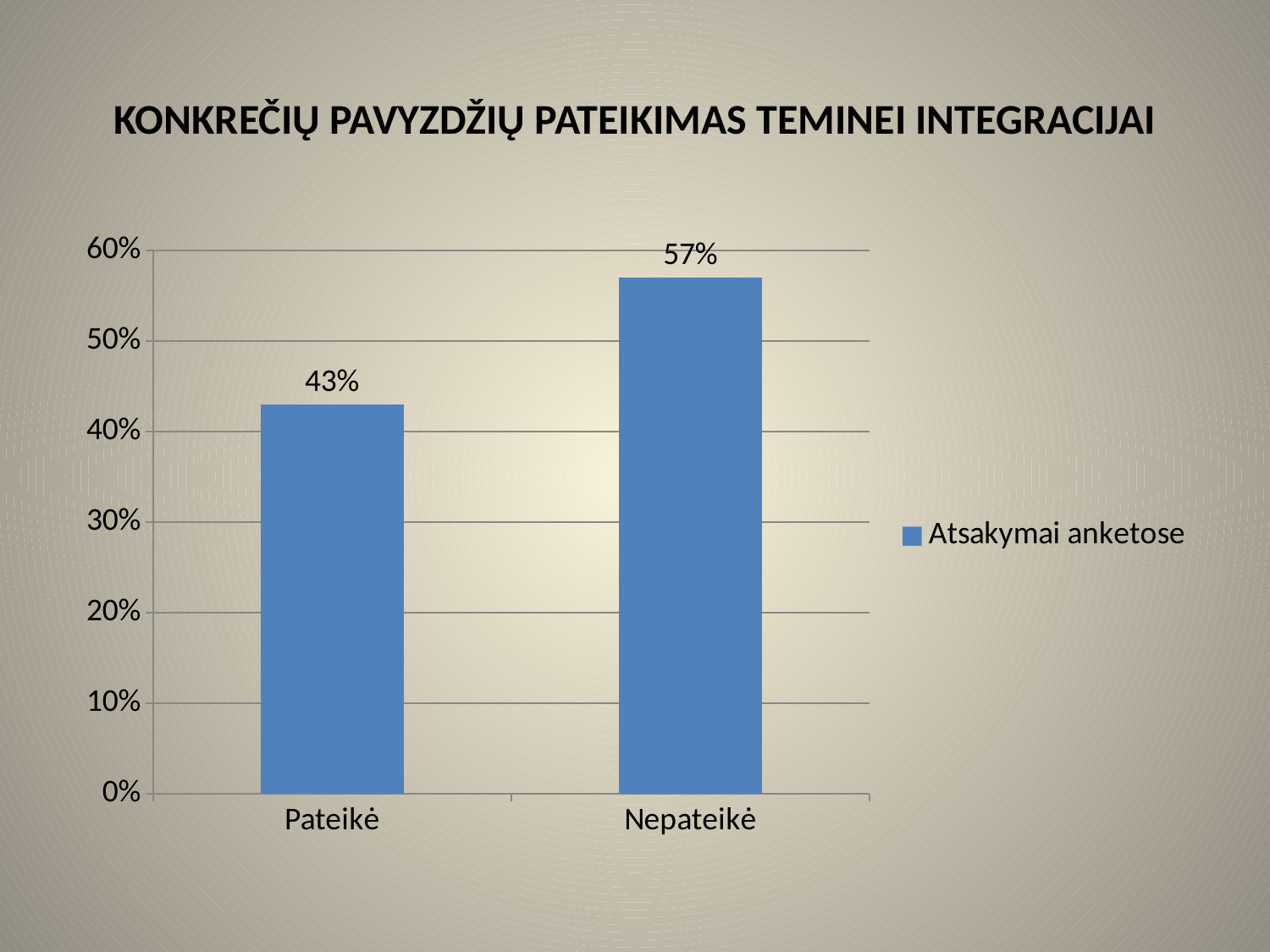
Is the value for Nepateikė greater or less than 50%? greater What is the value for Nepateikė? 57% What is the value for Pateikė? 43% Which category has the highest value? Nepateikė Which category has the lowest value? Pateikė Which is larger, the value for Pateikė or the value for Nepateikė? Nepateikė What is the difference between the values for Nepateikė and Pateikė? 14% How many series does the legend list? 1 How many categories are shown on the x axis? 2 What kind of chart is shown on the slide? bar chart What is the name of the series shown in the legend? Atsakymai anketose Is the value for Pateikė greater or less than 50%? less